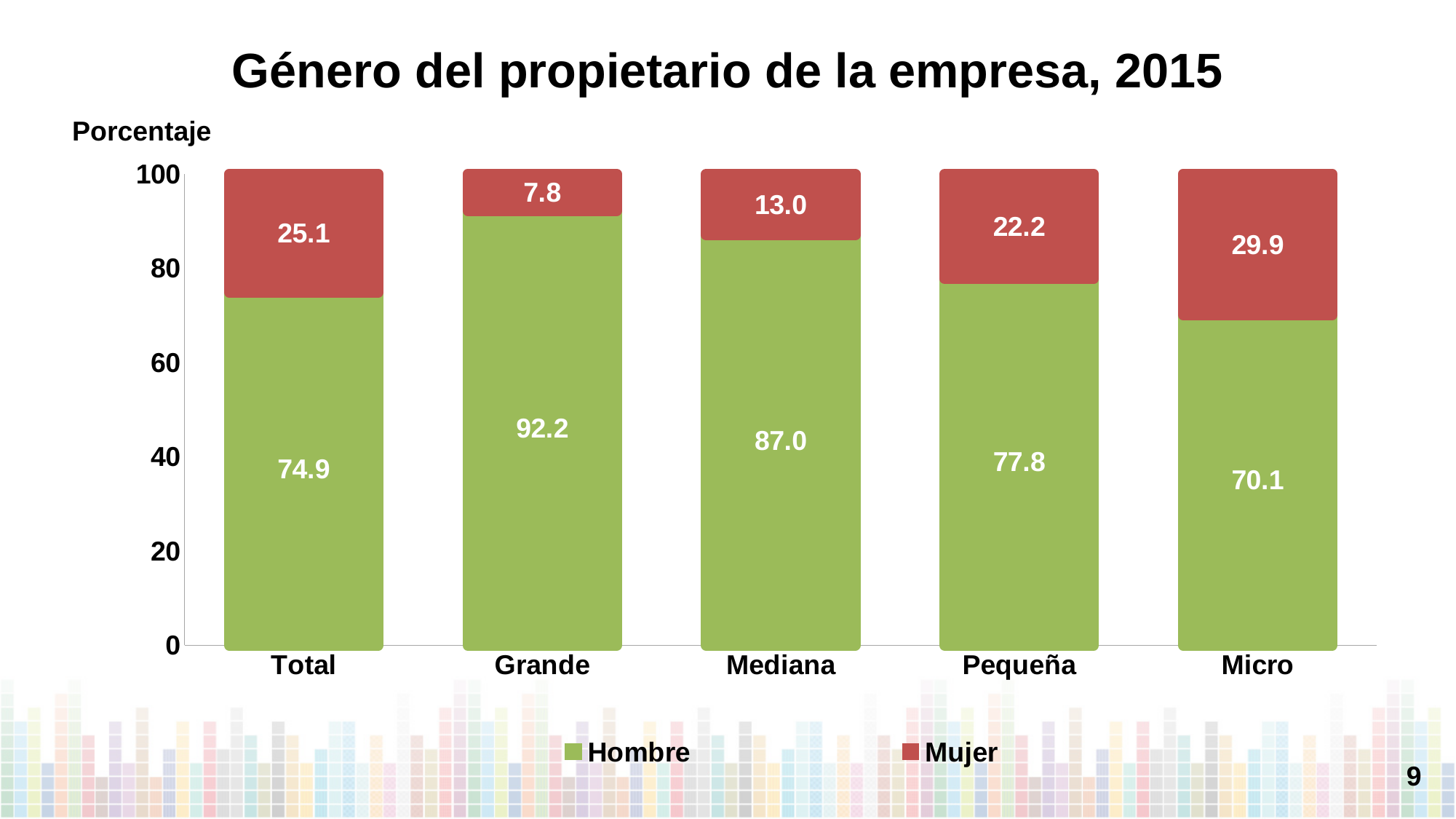
What is the Hombre value for Grande? 92.2 Which category has the lowest Hombre value? Micro Which is larger, the Mujer value for Pequeña or the Mujer value for Mediana? Pequeña How many series does the legend list? 2 What is the Mujer value for Micro? 29.9 What is the Mujer value for Total? 25.1 What is the total of the stacked bar for Pequeña? 100.0 How many categories are shown on the x axis? 5 What is the difference between the Hombre values for Grande and Mediana? 5.2 What is the title of the chart? Género del propietario de la empresa, 2015 Which category has the highest Mujer value? Micro What kind of chart is shown on the slide? Stacked bar chart